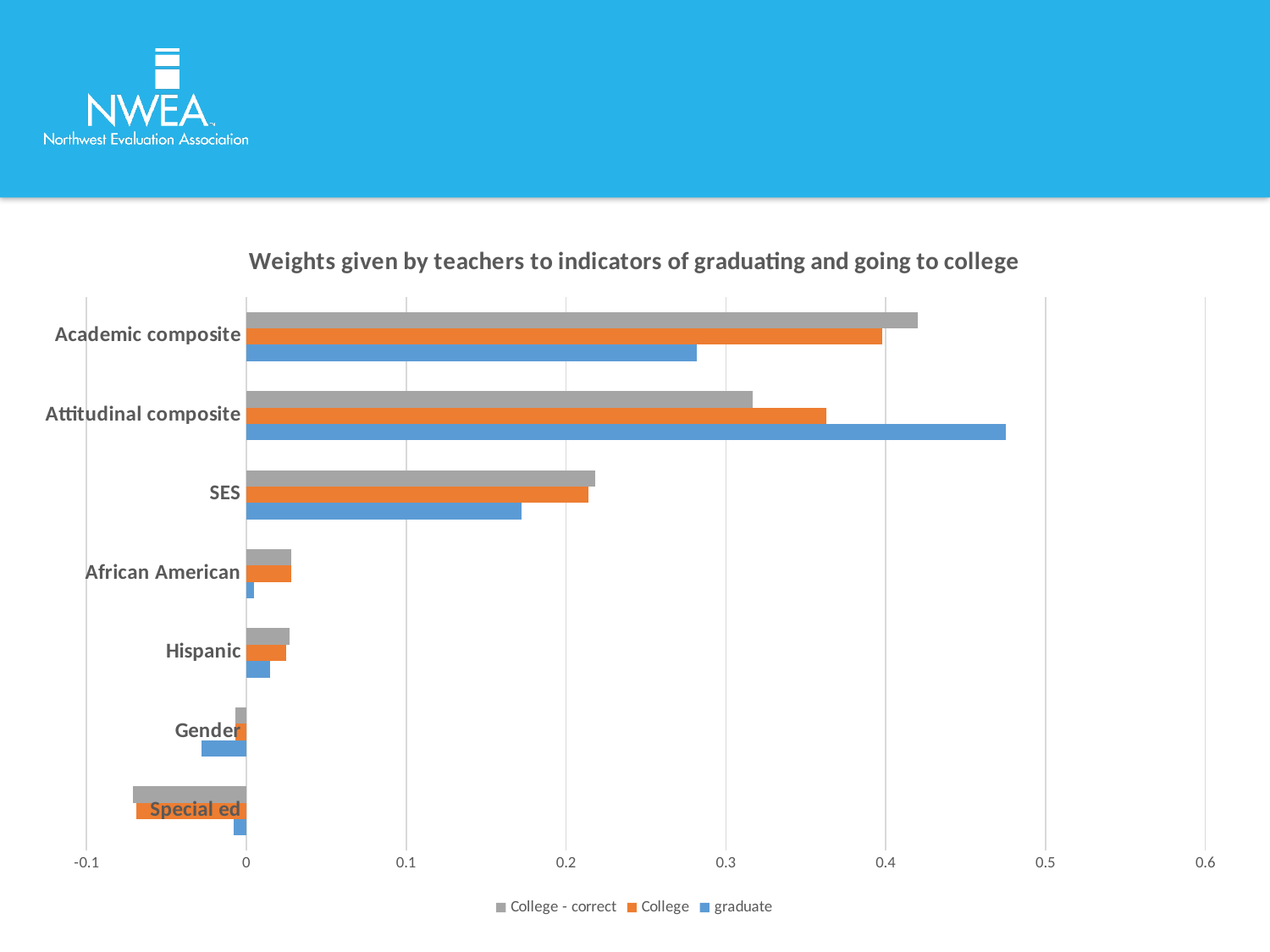
For Attitudinal composite, which is larger: the graduate value or the College - correct value? graduate How many categories are shown on the chart? 7 Which category has the highest value for the graduate series? Attitudinal composite Which category has the highest value for the College - correct series? Academic composite How many series does the legend list? 3 Which category has the lowest value for the College series? Special ed Which series is shown in orange in the legend? College What is the title of the chart? Weights given by teachers to indicators of graduating and going to college Is the graduate value for Attitudinal composite greater or less than 0.4? greater Which category has the lowest value for the graduate series? Gender Is the graduate value for Academic composite greater or less than 0.3? less What kind of chart is shown on the slide? Bar chart